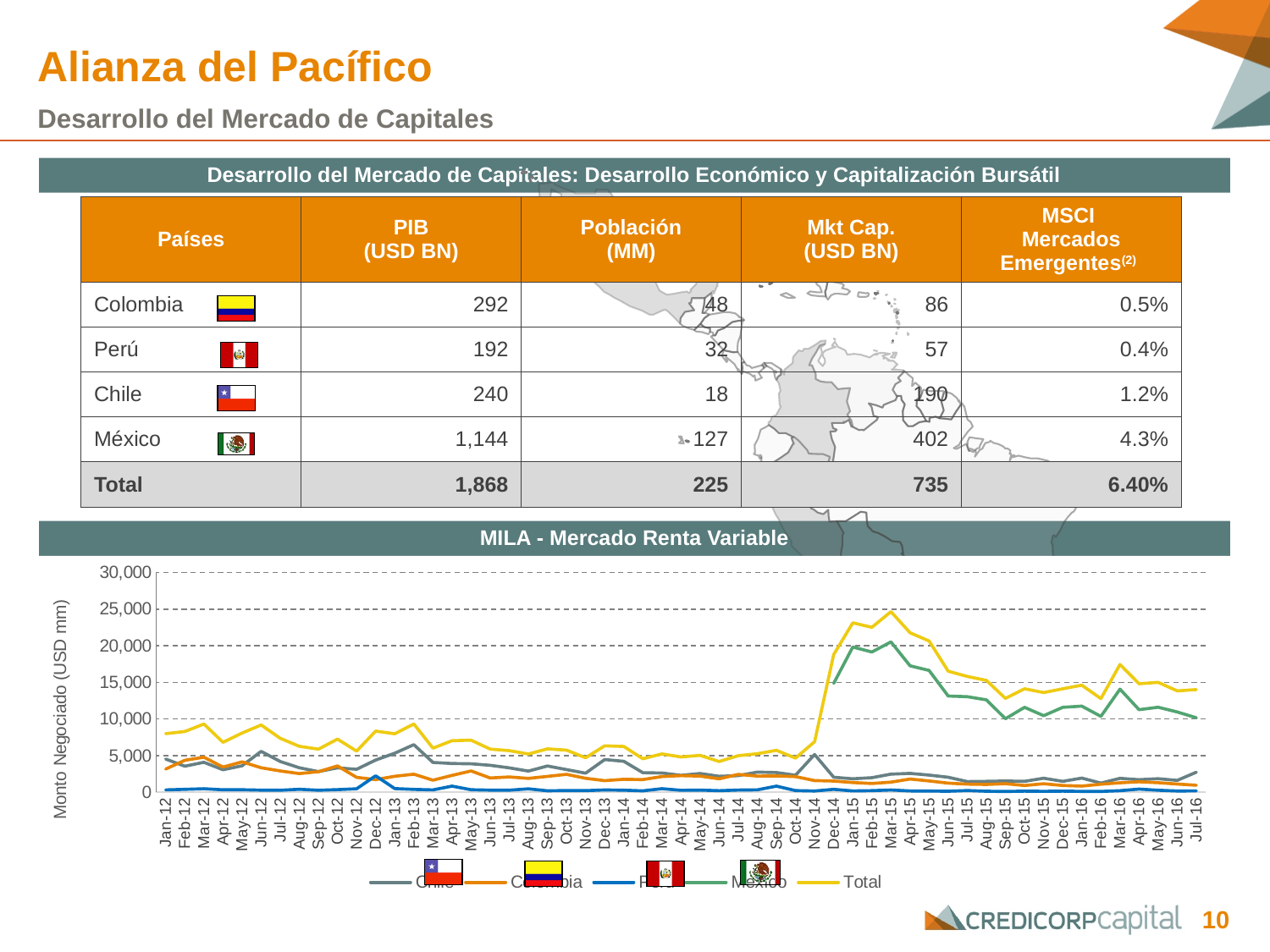
In the 'MILA - Mercado Renta Variable' chart, which is larger in Jan-15: the Total value or the Chile value? Total What kind of chart is the 'MILA - Mercado Renta Variable' chart? line chart In the 'MILA - Mercado Renta Variable' chart, is the Total value for Jan-12 greater or less than 10,000? less How many series does the legend of the 'MILA - Mercado Renta Variable' chart list? 5 What is the y-axis label of the 'MILA - Mercado Renta Variable' chart? Monto Negociado (USD mm) In the 'MILA - Mercado Renta Variable' chart, which series has the lowest values across the period? Perú In the 'MILA - Mercado Renta Variable' chart, which series has the highest value in Mar-15? Total In the 'MILA - Mercado Renta Variable' chart, is the Total value for Mar-15 greater or less than 20,000? greater What is the highest value shown on the y axis of the 'MILA - Mercado Renta Variable' chart? 30,000 In the 'MILA - Mercado Renta Variable' chart, is the Total value for Jul-16 greater or less than 10,000? greater In the 'MILA - Mercado Renta Variable' chart, does the Total series rise or fall between Oct-14 and Mar-15? rise